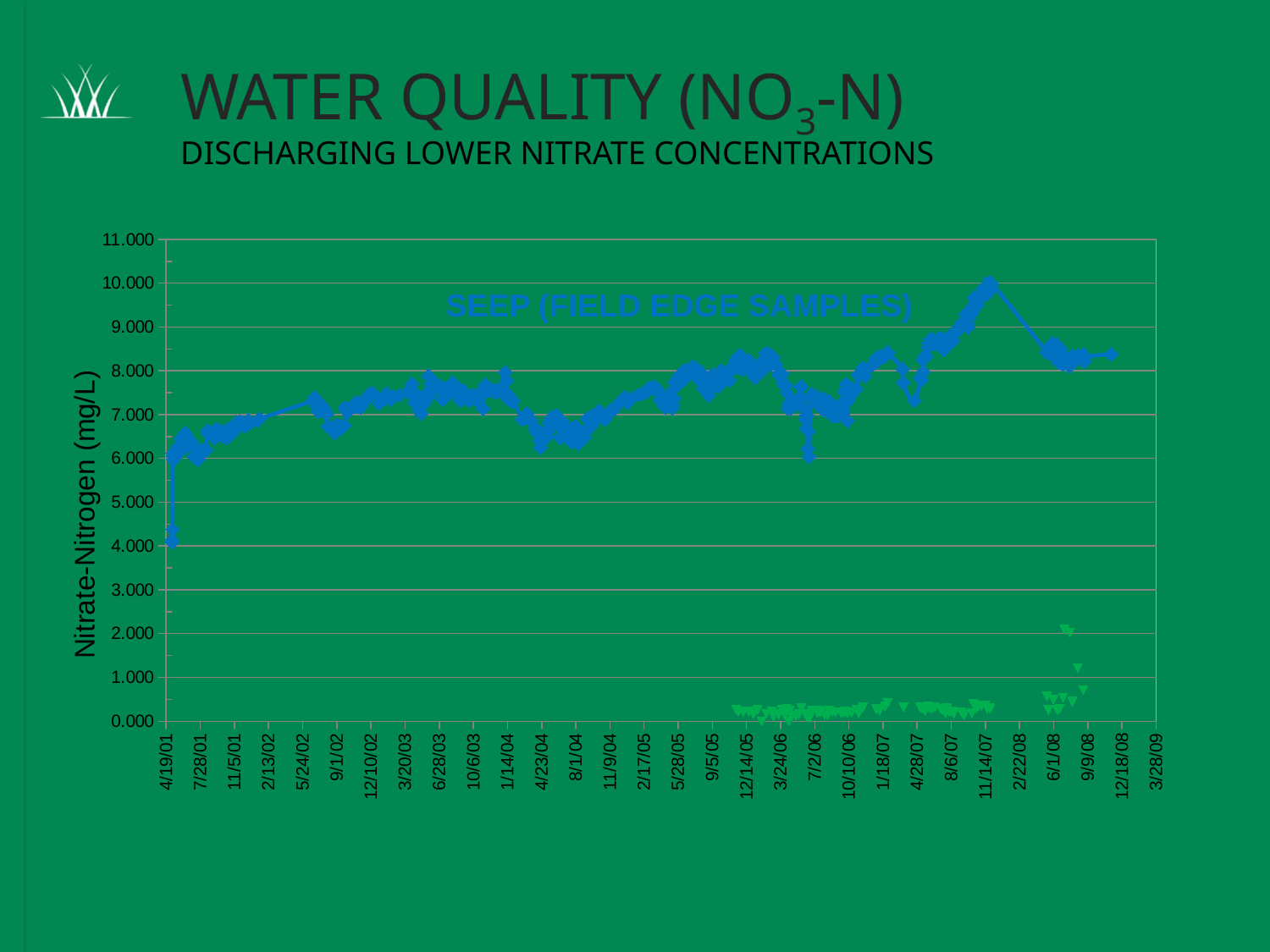
Which series has higher nitrate-nitrogen values, the blue diamond series or the green triangle series? blue diamond series What is the label on the vertical axis of the chart? Nitrate-Nitrogen (mg/L) Is the peak value of the blue series near 11/14/07 greater or less than 9.000? greater Are the values of the green triangle series greater or less than 3.000? less What kind of chart is shown on the slide? scatter chart What is the first date shown on the horizontal axis? 4/19/01 What text label appears inside the plot area above the blue data series? SEEP (FIELD EDGE SAMPLES) What is the highest tick value shown on the vertical axis? 11.000 How many data series are plotted on the chart? 2 Is the first blue value at 4/19/01 greater or less than 5.000? less Does the blue series generally rise or fall from 4/19/01 to 11/14/07? rise